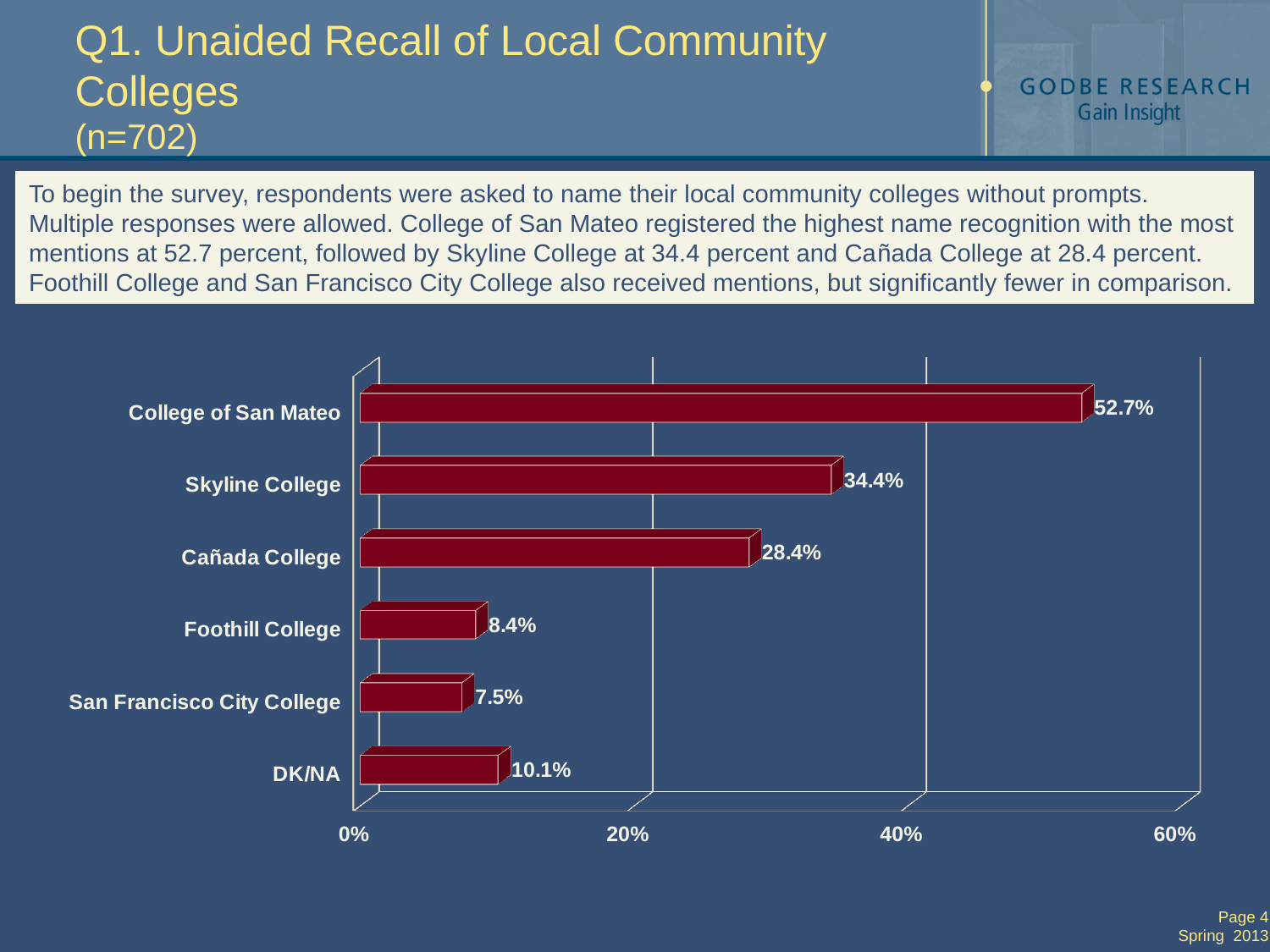
What percentage is shown for DK/NA? 10.1% Is the value for College of San Mateo greater or less than 40%? greater What is the difference between the values for Foothill College and San Francisco City College? 0.9% What is the difference between the values for College of San Mateo and Skyline College? 18.3% Which category has the highest value in the chart? College of San Mateo What kind of chart is shown on the slide? Bar chart Which category has the lowest value in the chart? San Francisco City College What is the value shown for Skyline College? 34.4% How many categories are shown in the chart? 6 What percentage of respondents mentioned College of San Mateo? 52.7% Which is larger, the value for Cañada College or the value for Skyline College? Skyline College What is the value shown for Cañada College? 28.4%